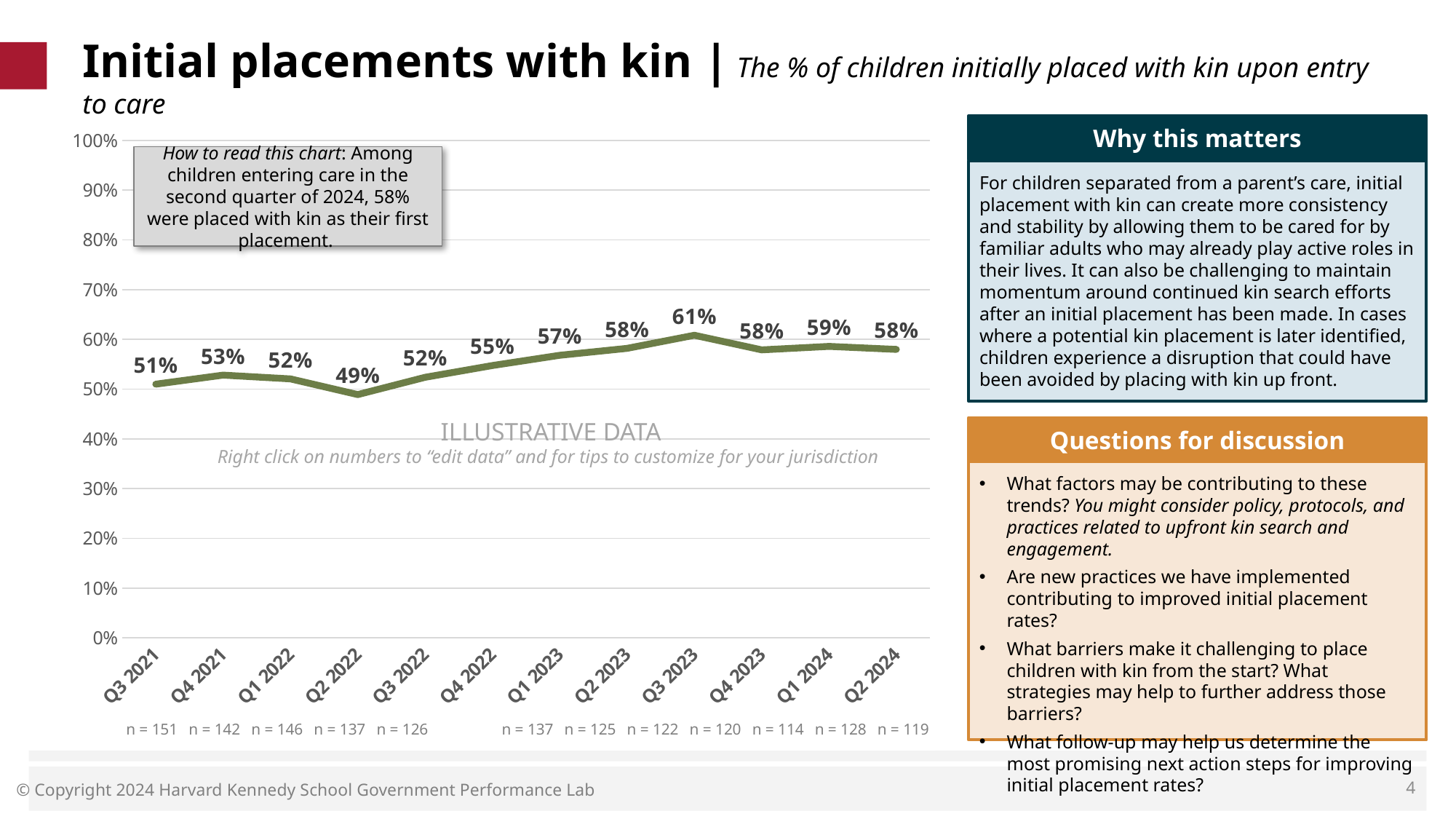
Which quarter has the highest value? Q3 2023 Overall, do the values rise or fall from Q3 2021 to Q2 2024? Rise Which quarter has the lowest value? Q2 2022 What is the value for Q3 2021? 51% How many quarters are plotted on the x axis? 12 Is the value for Q4 2022 greater or less than 50%? greater Which is larger, the value for Q1 2024 or the value for Q4 2021? Q1 2024 What type of chart is shown on the slide? Line chart What is the sample size (n) shown for Q2 2024? n = 119 What is the value for Q3 2023? 61% What is the difference between the values for Q3 2023 and Q2 2022? 12% What is the value for Q2 2022? 49%